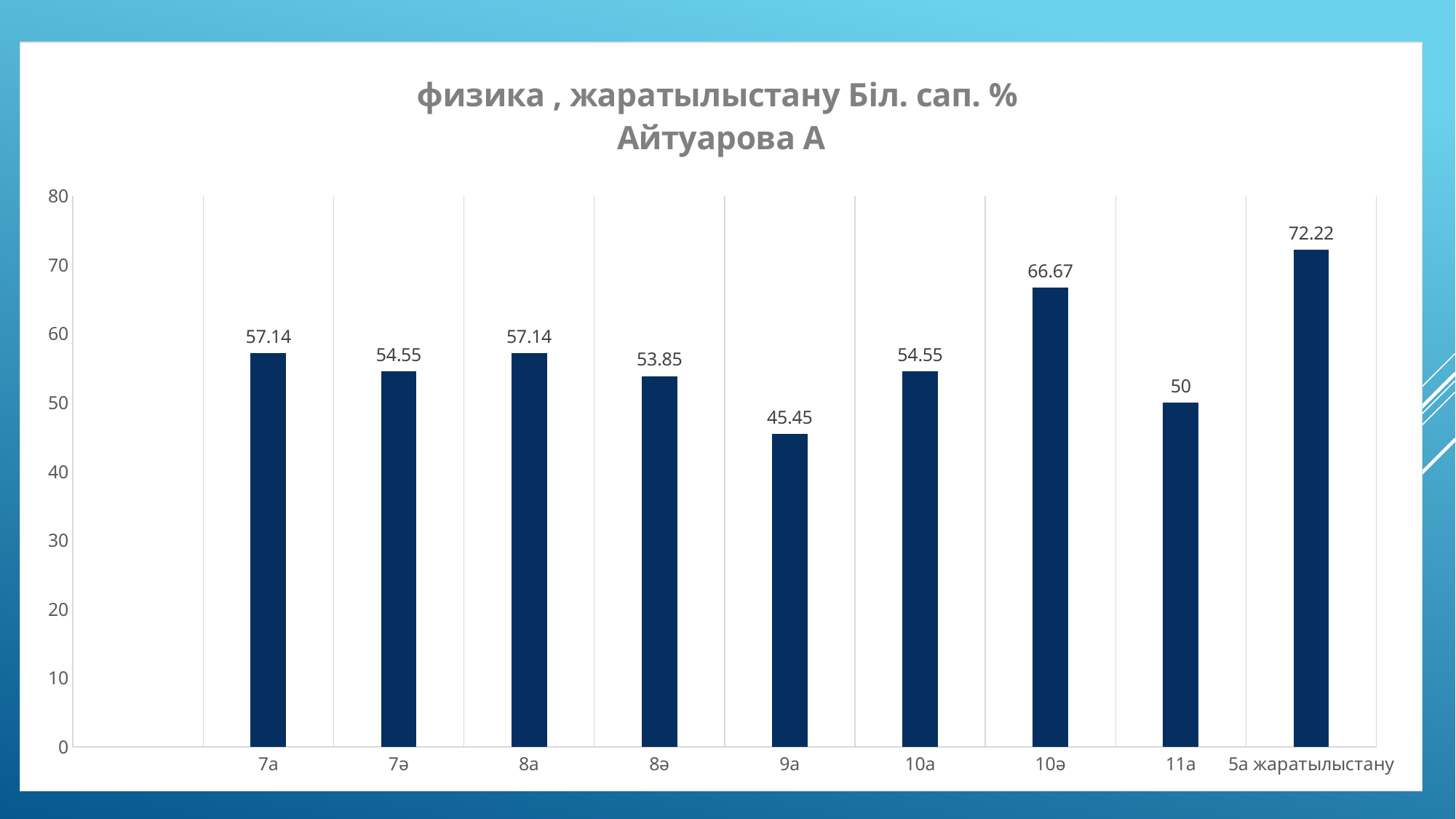
How many categories are shown on the x axis? 9 What is the value for 11а? 50 Which category has the lowest value? 9а Which category has the highest value? 5а жаратылыстану What is the value for 9а? 45.45 What is the difference between the values for 5а жаратылыстану and 9а? 26.77 What is the difference between the values for 10ә and 11а? 16.67 Which is larger, the value for 7а or the value for 8ә? 7а Is the value for 10ә greater or less than 60? greater What is the value for 5а жаратылыстану? 72.22 What is the value for 10ә? 66.67 What kind of chart is shown on the slide? bar chart